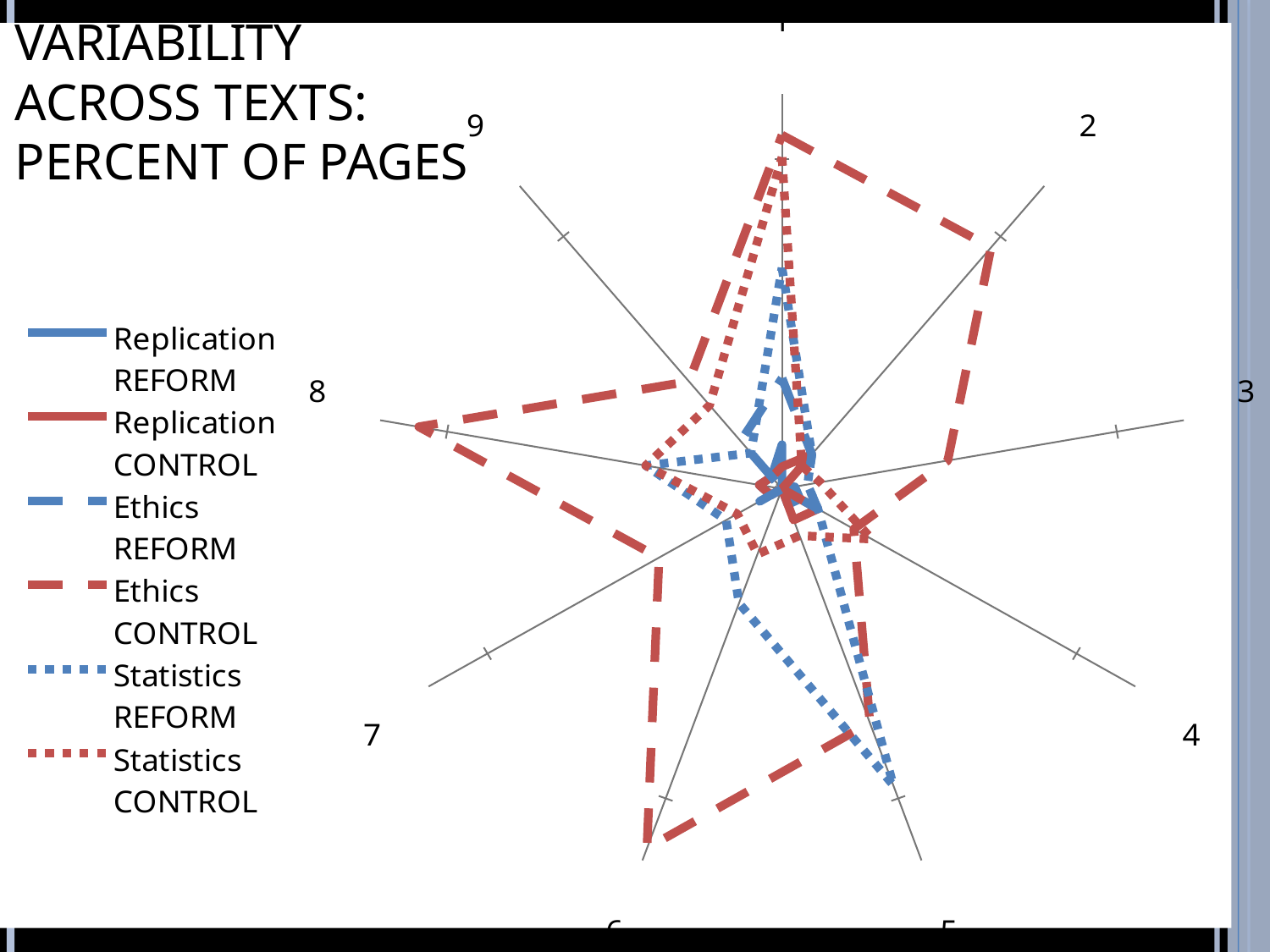
What is the title of the chart on the slide? VARIABILITY ACROSS TEXTS: PERCENT OF PAGES Which colour is used for the CONTROL series in the legend? Red How many axes (categories) does the radar chart have? 9 On axis 2, which series extends further from the centre: Ethics CONTROL or Ethics REFORM? Ethics CONTROL On axis 8, which series extends further from the centre: Ethics CONTROL or Ethics REFORM? Ethics CONTROL What kind of chart is shown on the slide? Radar chart How many series does the legend list? 6 On axis 5, which series extends further from the centre: Statistics REFORM or Replication REFORM? Statistics REFORM Which series reaches the outermost points on the radar chart? Ethics CONTROL